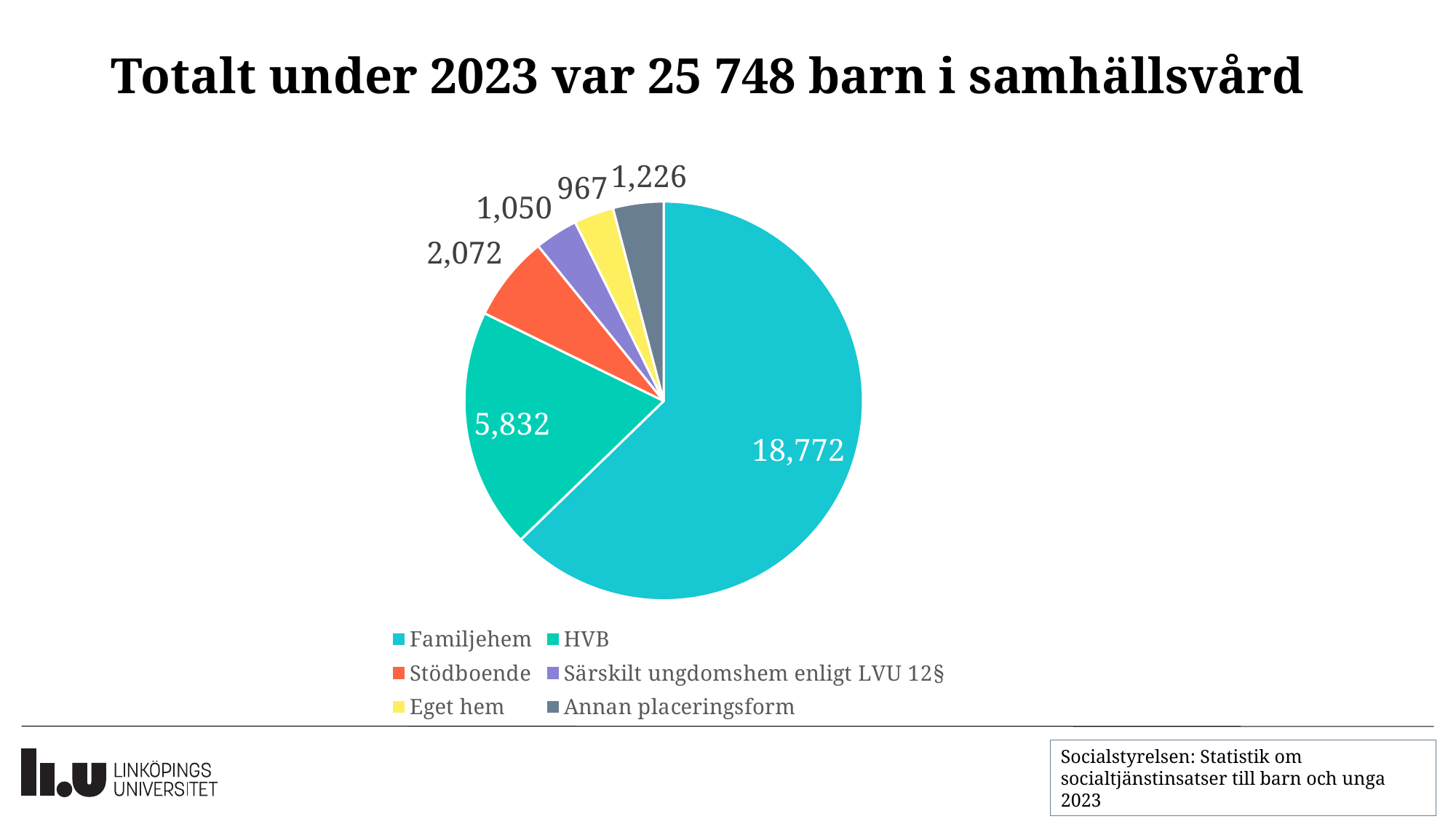
Which category has the largest slice? Familjehem What is the value for Annan placeringsform? 1,226 What type of chart is shown on the slide? pie chart What is the value for Särskilt ungdomshem enligt LVU 12§? 1,050 Which is larger, Annan placeringsform or Eget hem? Annan placeringsform What is the value for Eget hem? 967 Which category has the smallest slice? Eget hem What is the value for HVB? 5,832 What is the value for Stödboende? 2,072 What is the difference between the values for Familjehem and HVB? 12,940 How many categories does the pie chart show? 6 What is the value for Familjehem? 18,772